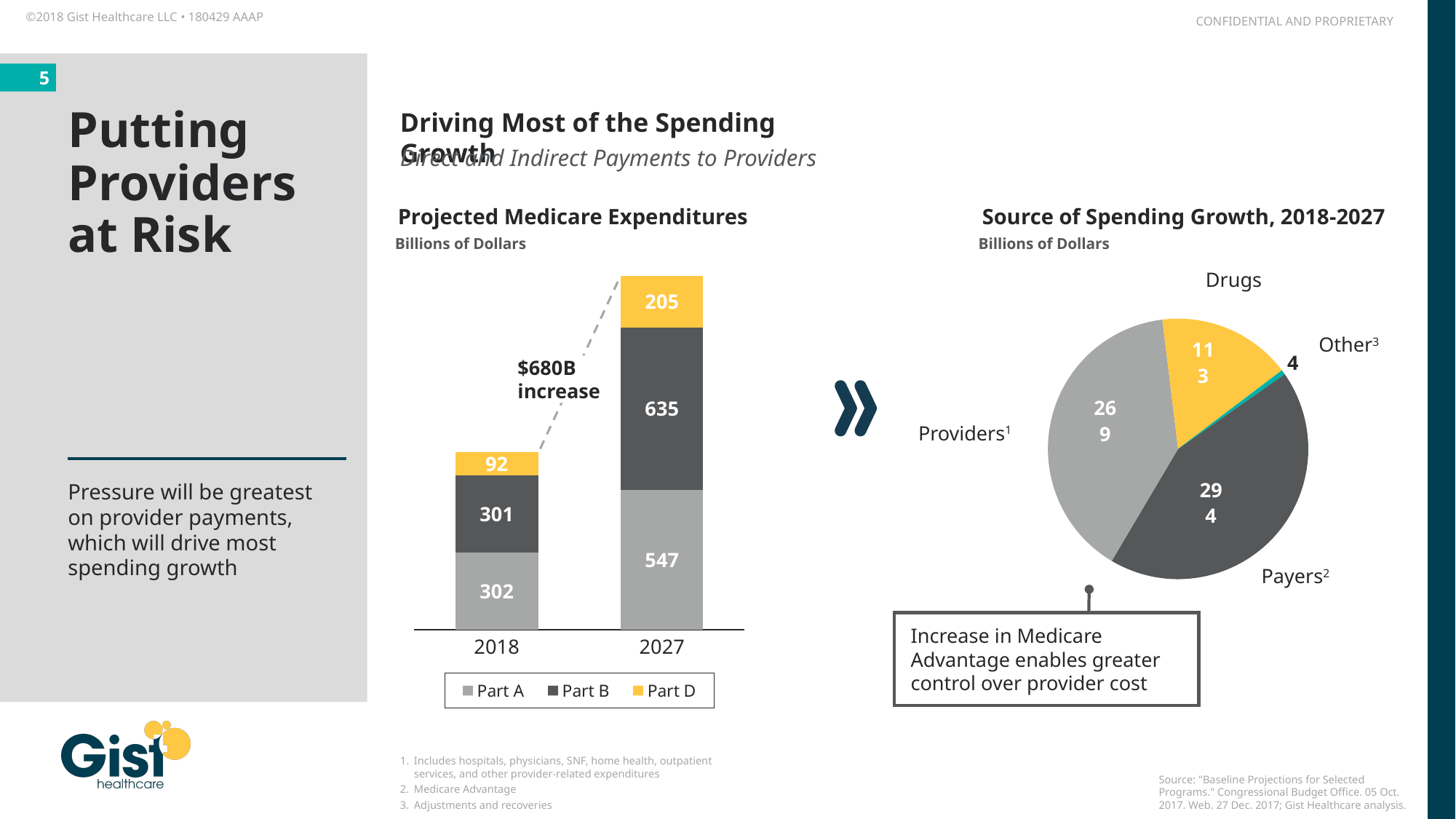
In the Projected Medicare Expenditures chart, by how much does Part B increase from 2018 to 2027? 334 In the Projected Medicare Expenditures chart, what is the value for Part D in 2027? 205 In the Source of Spending Growth, 2018-2027 pie chart, which category has the smallest value? Other In the Projected Medicare Expenditures chart, what is the value for Part B in 2027? 635 What kind of chart is the Projected Medicare Expenditures chart? Stacked bar chart In the Source of Spending Growth, 2018-2027 pie chart, which category has the largest value? Payers In the Projected Medicare Expenditures chart, what is the total of the 2018 stacked bar? 695 In the Projected Medicare Expenditures chart, do the total expenditures rise or fall from 2018 to 2027? Rise How many categories are shown in the Source of Spending Growth, 2018-2027 pie chart? 4 In the Source of Spending Growth, 2018-2027 pie chart, what is the value for Payers? 294 In the Projected Medicare Expenditures chart, what is the value for Part A in 2018? 302 How many series does the legend of the Projected Medicare Expenditures chart list? 3